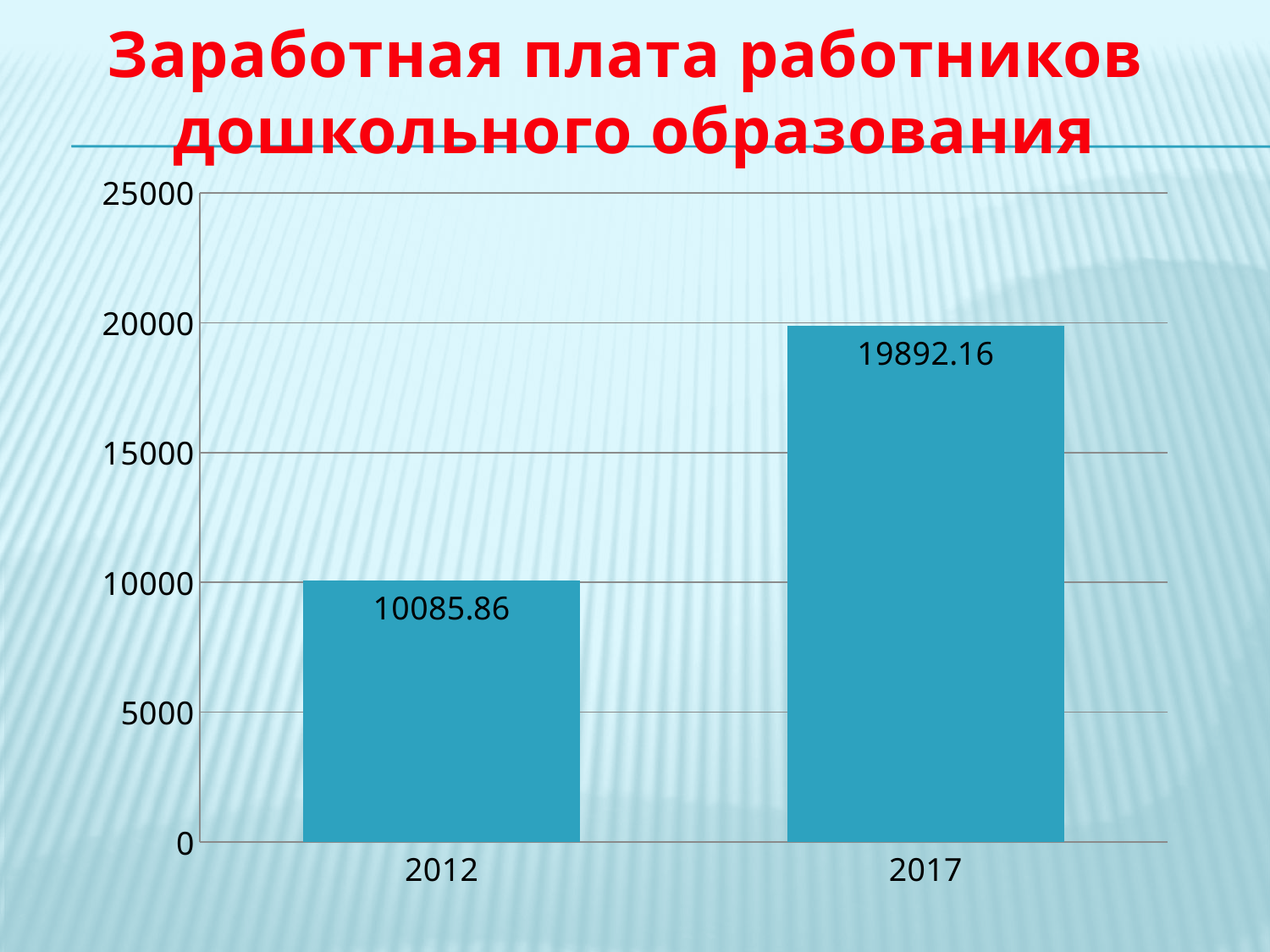
What is the title of the slide? Заработная плата работников дошкольного образования How many categories are shown on the x axis? 2 Which is larger, the value for 2012 or the value for 2017? 2017 Which year has the lowest value? 2012 What is the value for 2017? 19892.16 What is the difference between the values for 2017 and 2012? 9806.30 Is the value for 2017 greater or less than 15000? greater Is the value for 2012 greater or less than 15000? less Do the values rise or fall from 2012 to 2017? rise What kind of chart is shown on the slide? bar chart What is the value for 2012? 10085.86 Which year has the highest value? 2017